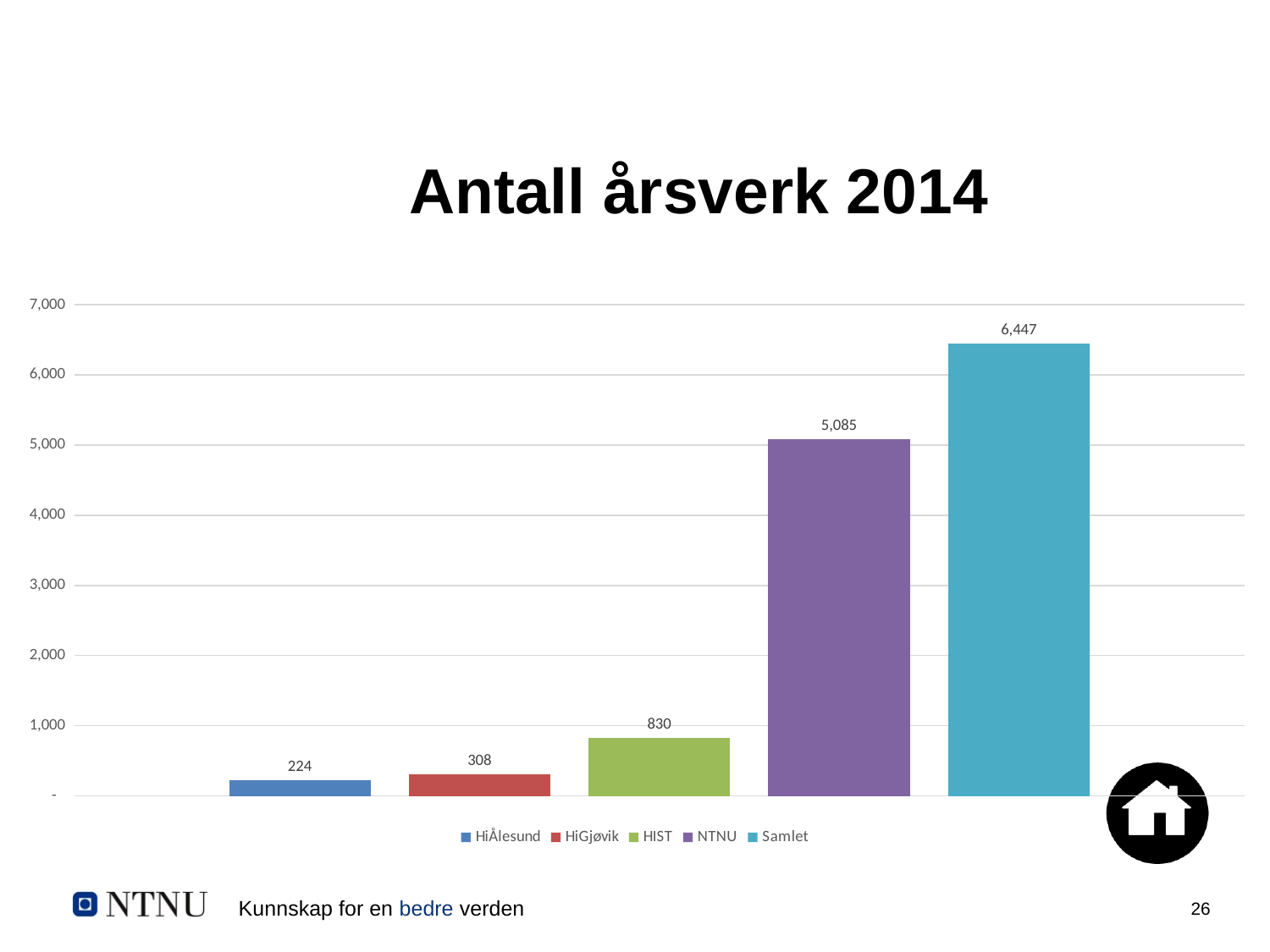
What kind of chart is shown on the slide? bar chart What is the difference between the values for Samlet and NTNU? 1,362 What is the value for HiÅlesund? 224 Which category has the lowest value? HiÅlesund What is the value for NTNU? 5,085 What is the value for HIST? 830 Which is larger, the value for HIST or the value for HiGjøvik? HIST How many bars are shown in the chart? 5 What is the difference between the values for HiGjøvik and HiÅlesund? 84 Which category has the highest value? Samlet What is the title of the chart? Antall årsverk 2014 Is the value for Samlet greater or less than 6,000? greater